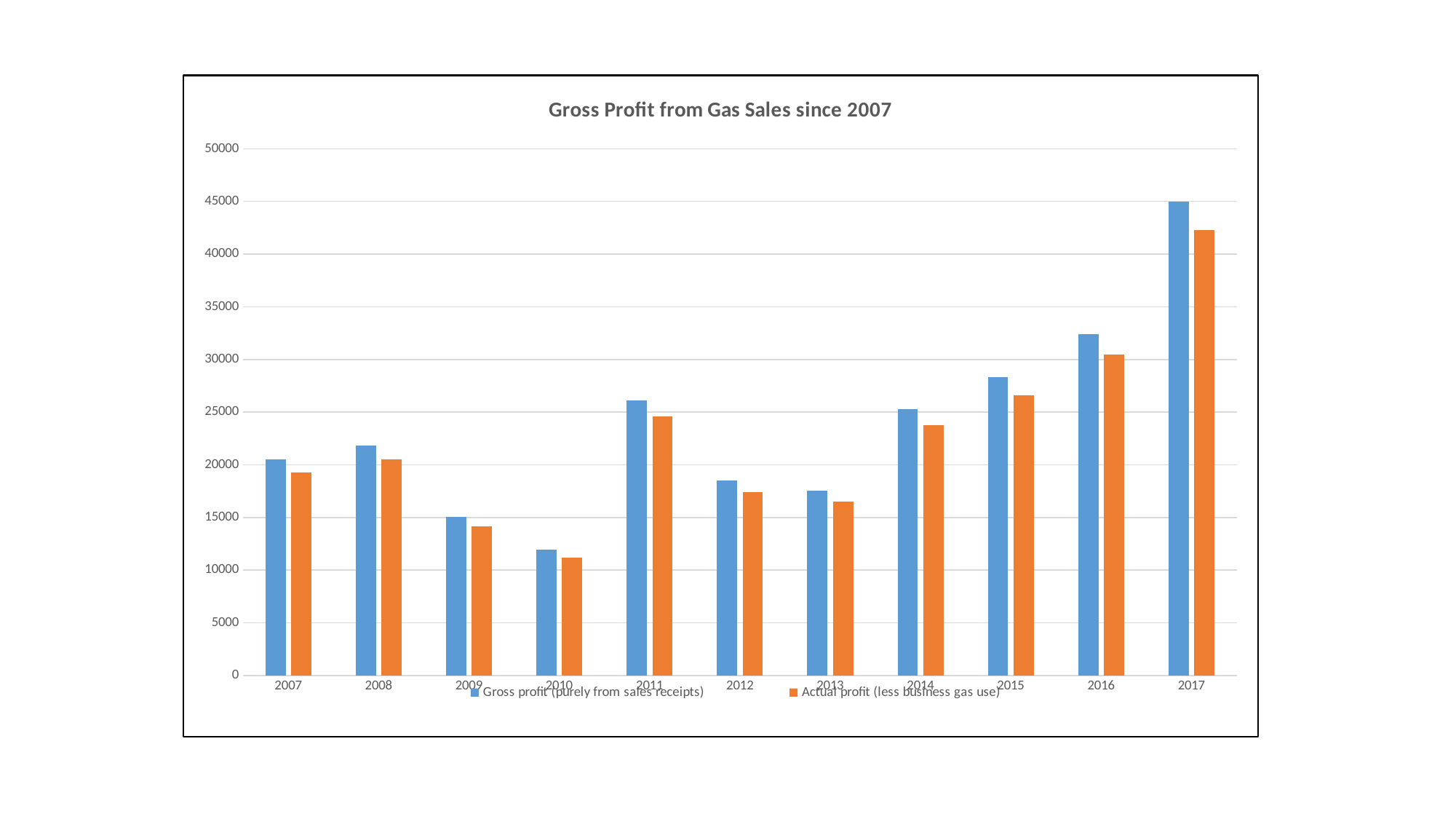
Which year has the highest gross profit (purely from sales receipts)? 2017 Is the actual profit (less business gas use) for 2009 greater or less than 15000? less What is the title of the chart? Gross Profit from Gas Sales since 2007 Is the actual profit (less business gas use) for 2016 greater or less than 25000? greater What kind of chart is shown on the slide? Bar chart Which year has the lowest actual profit (less business gas use)? 2010 How many years are shown on the x axis? 11 Is the gross profit (purely from sales receipts) for 2010 greater or less than 15000? less Which is larger, the gross profit (purely from sales receipts) for 2008 or for 2012? 2008 Do the gross profit values rise or fall from 2013 to 2017? Rise How many series does the legend list? 2